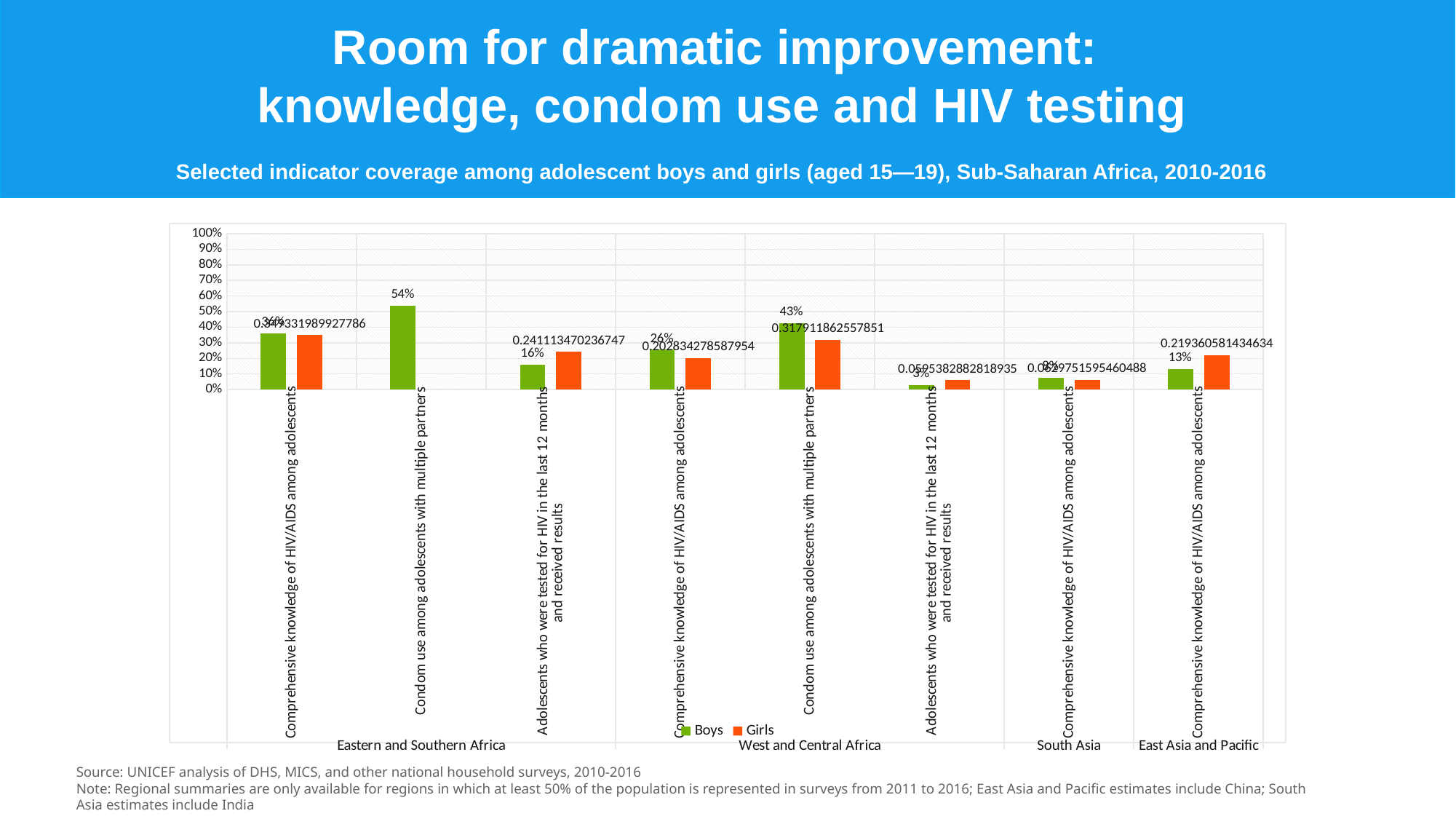
Which indicator has the highest value for Boys? Condom use among adolescents with multiple partners (Eastern and Southern Africa) For adolescents tested for HIV in the last 12 months in Eastern and Southern Africa, which is larger, the Boys value or the Girls value? Girls What is the value for Boys for adolescents who were tested for HIV in the last 12 months and received results in Eastern and Southern Africa? 16% Is the Girls value for adolescents tested for HIV in the last 12 months in West and Central Africa greater or less than 10%? less What is the difference between the Boys values for condom use among adolescents with multiple partners in Eastern and Southern Africa and in West and Central Africa? 11% What kind of chart is shown on the slide? bar chart Which indicator has the lowest value for Boys? Adolescents who were tested for HIV in the last 12 months and received results (West and Central Africa) How many series does the legend list? 2 What is the value for Boys for condom use among adolescents with multiple partners in West and Central Africa? 43% What is the value for Boys for comprehensive knowledge of HIV/AIDS among adolescents in East Asia and Pacific? 13% What is the value for Boys for comprehensive knowledge of HIV/AIDS among adolescents in West and Central Africa? 26% What is the value for Boys for condom use among adolescents with multiple partners in Eastern and Southern Africa? 54%